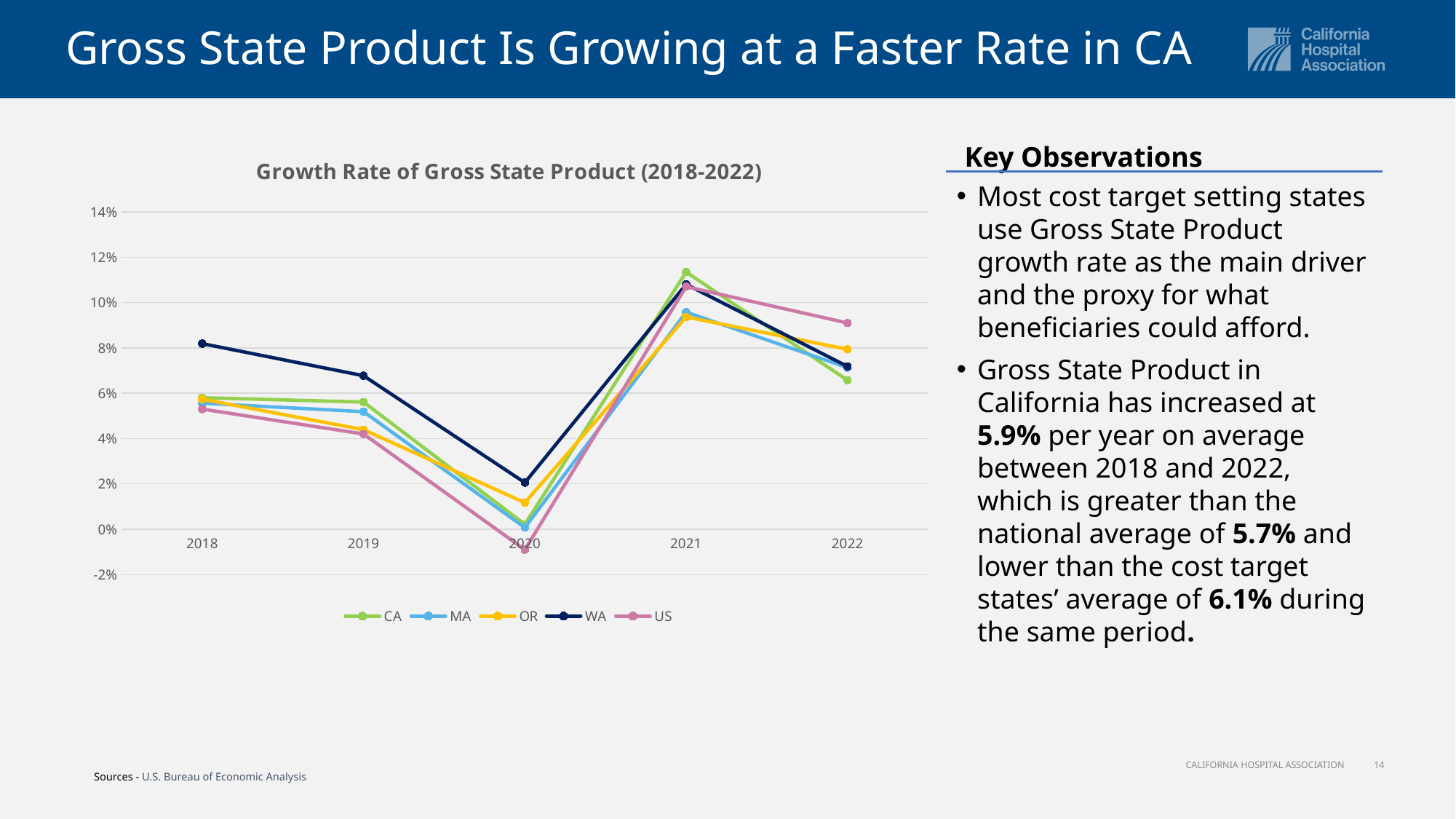
What kind of chart is shown on the slide? Line chart In 2022, which is larger, the value for US or the value for CA? US How many series does the legend of the chart list? 5 Which series has the lowest growth rate in 2020? US What is the title of the chart? Growth Rate of Gross State Product (2018-2022) Is the value for WA in 2018 greater or less than 6%? greater Does the WA line rise or fall from 2018 to 2020? Fall Which series has the highest growth rate in 2022? US Is the value for CA in 2021 greater or less than 10%? greater Is the value for US in 2020 greater or less than 0%? less Which series has the highest growth rate in 2018? WA How many years are shown on the x axis of the chart? 5